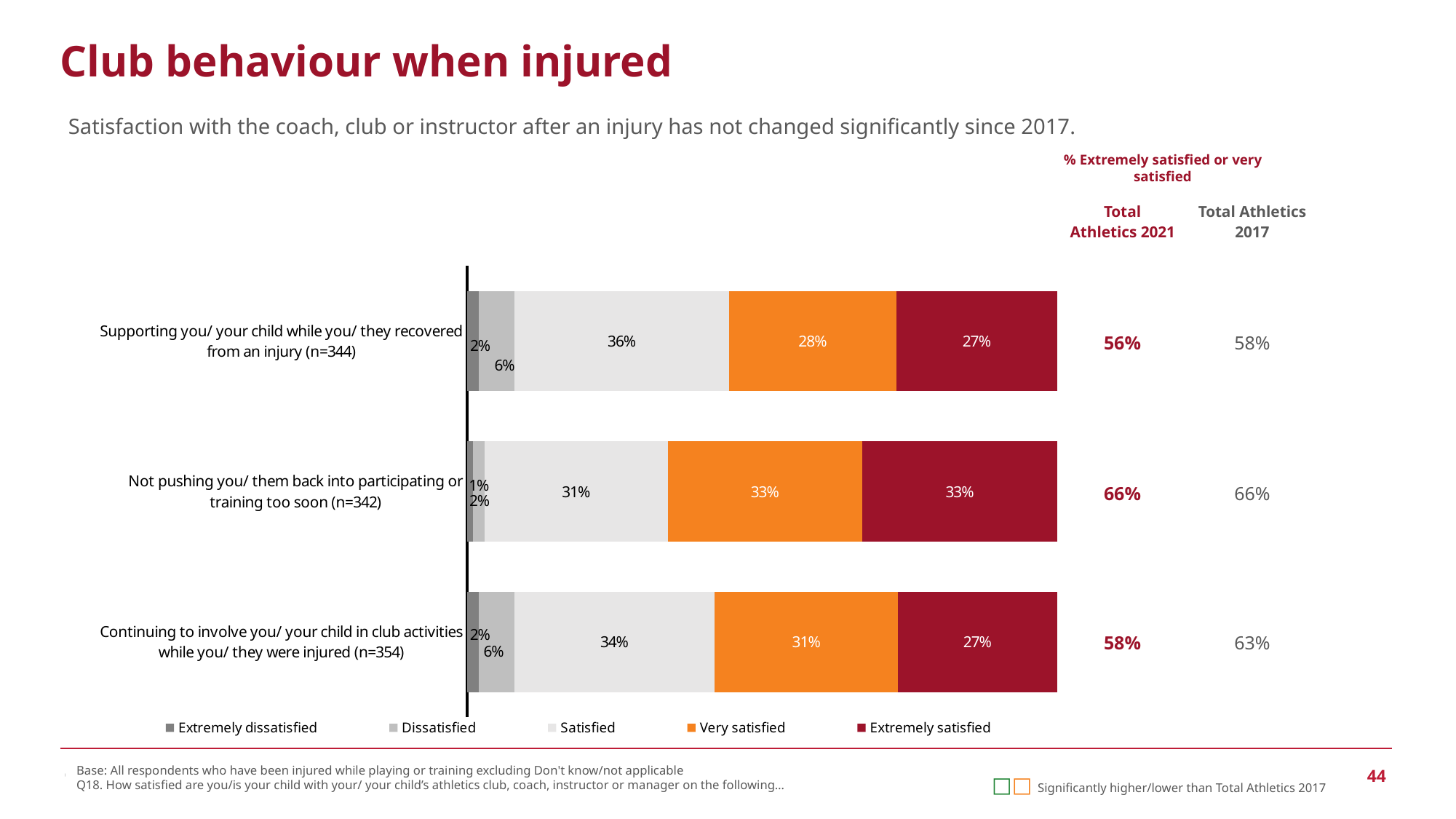
What kind of chart is shown on the slide? Stacked bar chart What is the difference between the 'Very satisfied' percentages for 'Not pushing you/ them back into participating or training too soon' and 'Supporting you/ your child while you/ they recovered from an injury'? 5% What percentage were 'Satisfied' with 'Supporting you/ your child while you/ they recovered from an injury'? 36% What is the 'Total Athletics 2017' value for '% Extremely satisfied or very satisfied' for 'Continuing to involve you/ your child in club activities while you/ they were injured'? 63% Which category has the lowest 'Very satisfied' percentage? Supporting you/ your child while you/ they recovered from an injury (n=344) How many categories (club behaviours) are plotted in the chart? 3 How many series does the legend list? 5 What percentage were 'Dissatisfied' with 'Not pushing you/ them back into participating or training too soon'? 2% What is the total of the stacked bar for 'Not pushing you/ them back into participating or training too soon'? 100% Which is larger: the 'Satisfied' percentage for 'Supporting you/ your child while you/ they recovered from an injury' or for 'Continuing to involve you/ your child in club activities while you/ they were injured'? Supporting you/ your child while you/ they recovered from an injury Which category has the highest 'Extremely satisfied' percentage? Not pushing you/ them back into participating or training too soon (n=342) What percentage were 'Very satisfied' with 'Continuing to involve you/ your child in club activities while you/ they were injured'? 31%